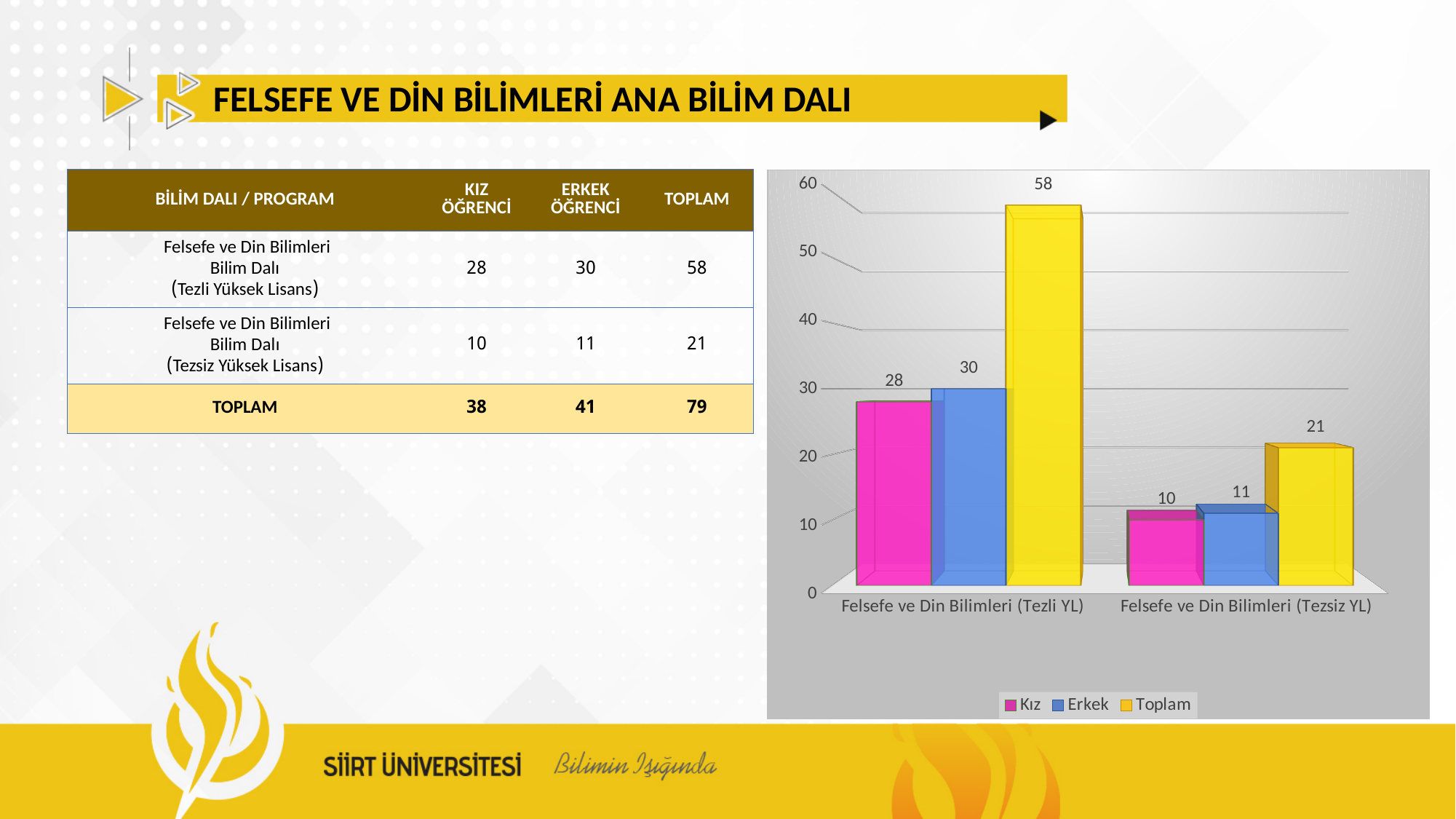
In the chart, is the Erkek value for Tezli YL larger or smaller than the Kız value for Tezli YL? larger What is the Toplam value for Felsefe ve Din Bilimleri (Tezli YL) in the chart? 58 Is the Toplam value for Felsefe ve Din Bilimleri (Tezsiz YL) greater or less than 30? less How many categories are shown on the x axis of the chart? 2 Which category has the lowest Kız value in the chart? Felsefe ve Din Bilimleri (Tezsiz YL) What is the Kız value for Felsefe ve Din Bilimleri (Tezli YL) in the chart? 28 What is the difference between the Toplam values for Tezli YL and Tezsiz YL in the chart? 37 Which category has the highest Toplam value in the chart? Felsefe ve Din Bilimleri (Tezli YL) What kind of chart is shown on the slide? bar chart What is the Erkek value for Felsefe ve Din Bilimleri (Tezsiz YL) in the chart? 11 What colour represents the Toplam series in the chart? yellow How many series does the chart legend list? 3